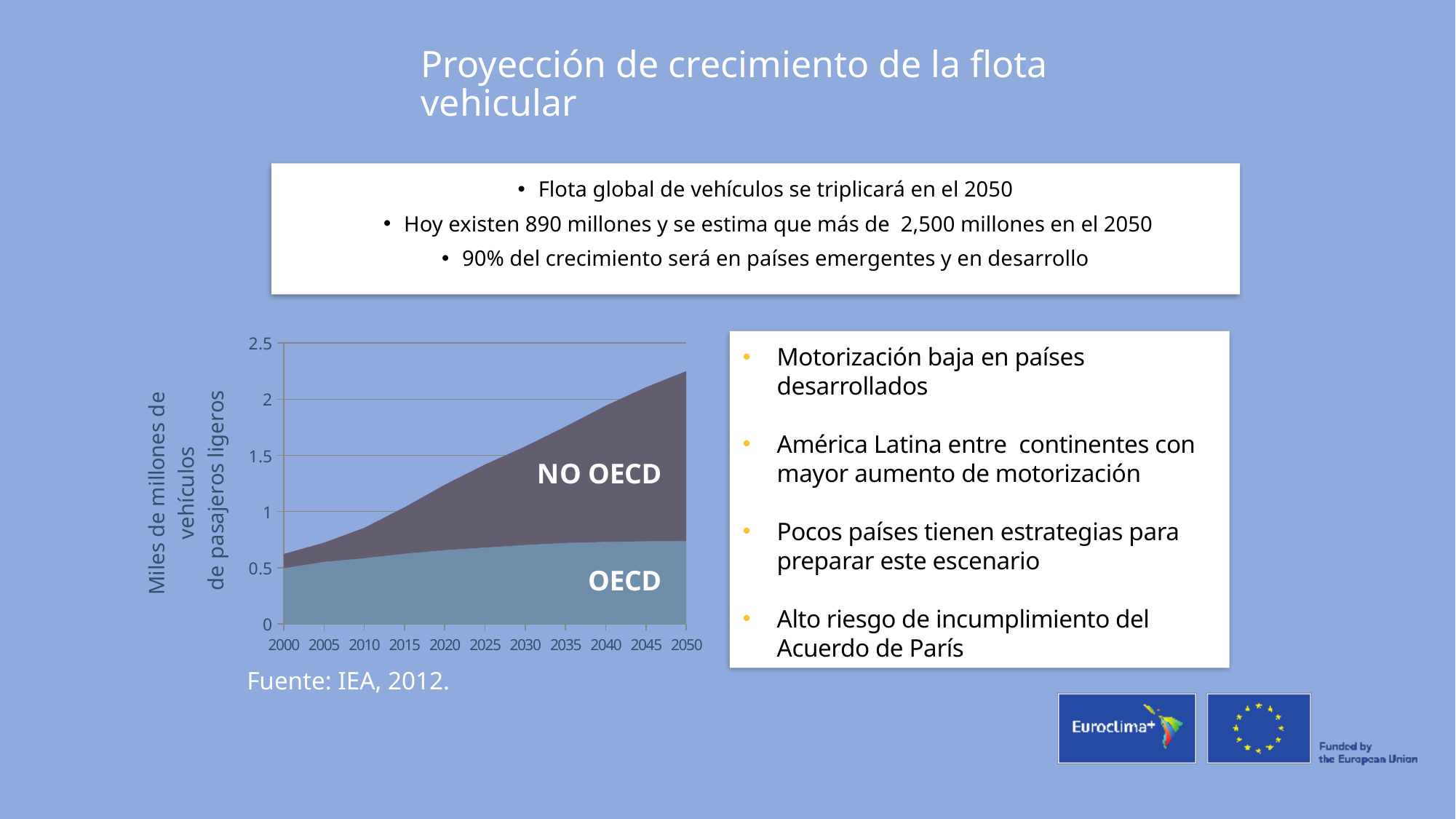
What is the first year shown on the x axis? 2000 How many years are marked along the x axis of the chart? 11 What are the two series labelled in the chart? NO OECD and OECD Does the total vehicle fleet rise or fall from 2000 to 2050? Rises How many series are shown in the chart? 2 Is the total stacked value in 2000 greater or less than 1? less What kind of chart is shown on the slide? Stacked area chart Is the OECD value in 2050 greater or less than 1? less What is the last year shown on the x axis? 2050 In 2050, which series is larger, NO OECD or OECD? NO OECD What is the label of the y axis? Miles de millones de vehículos de pasajeros ligeros Is the total stacked value in 2050 greater or less than 2? greater